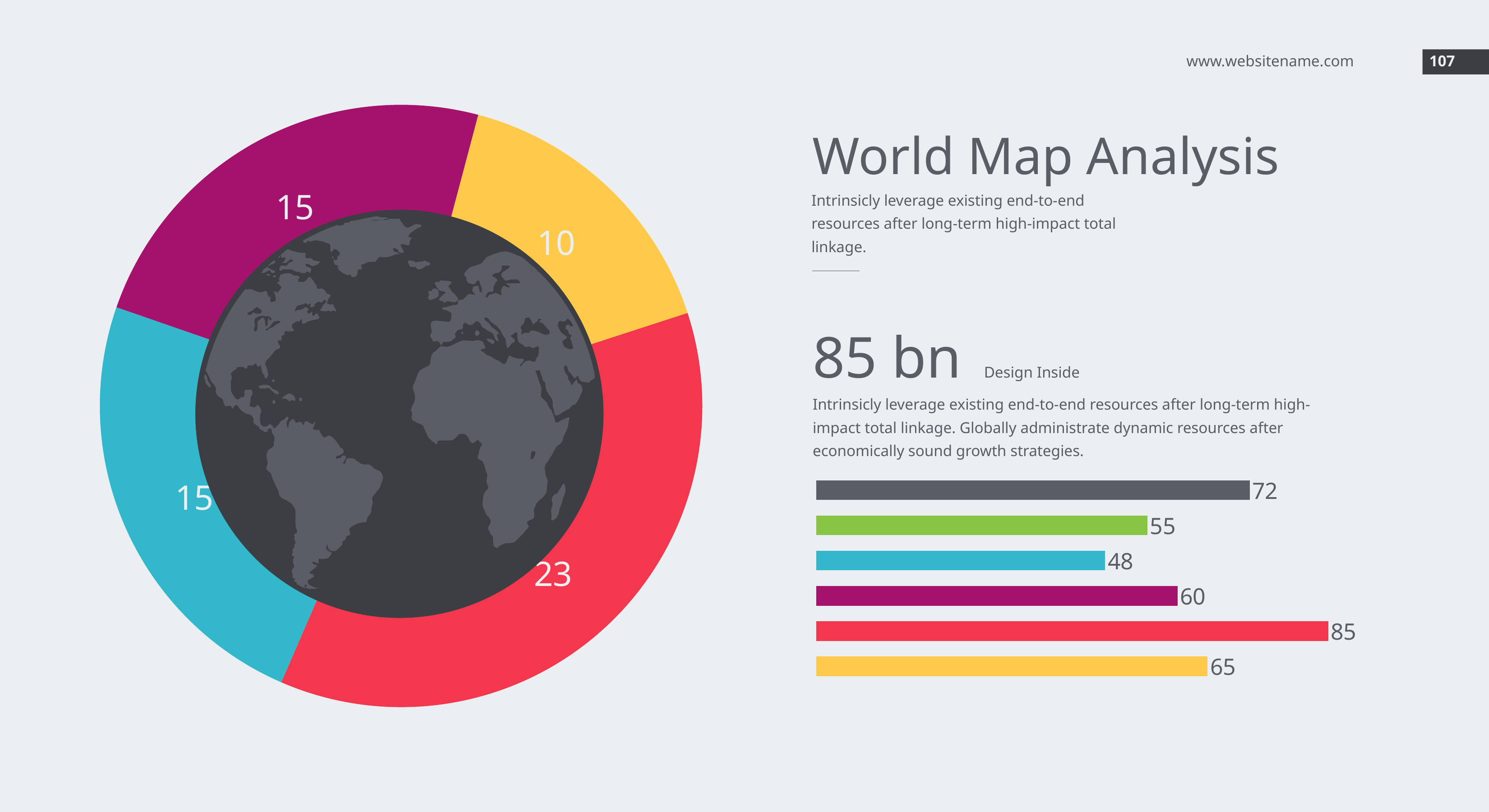
On the bar chart on the right, how many bars are there? 6 On the donut chart on the left, what is the difference between the red slice and the yellow slice? 13 On the donut chart on the left, what value is shown on the red slice? 23 On the donut chart on the left, which slice has the largest value? the red slice (23) On the donut chart on the left, what value is shown on the yellow slice? 10 On the bar chart on the right, what is the value of the red bar? 85 On the bar chart on the right, what is the difference between the highest bar and the lowest bar? 37 On the bar chart on the right, what is the value of the green bar? 55 On the donut chart on the left, how many slices are there? 4 On the donut chart on the left, which slice has the smallest value? the yellow slice (10) On the bar chart on the right, which bar has the lowest value? the cyan bar (48) What kind of chart is shown on the right side of the slide? bar chart